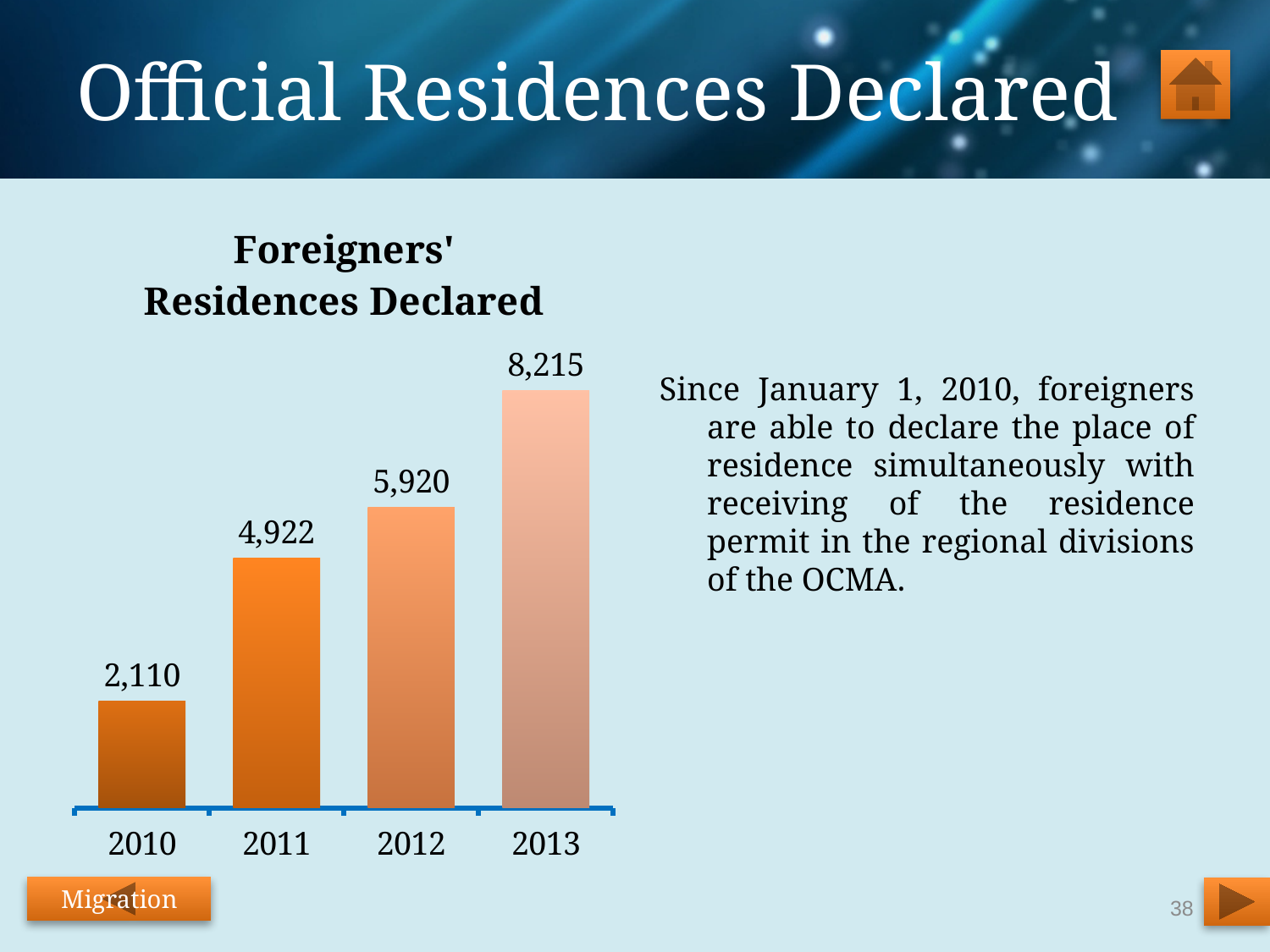
Do the values in the Foreigners' Residences Declared chart rise or fall from 2010 to 2013? rise What is the value for 2010 in the Foreigners' Residences Declared chart? 2,110 What kind of chart is the Foreigners' Residences Declared chart? bar chart Which is larger in the Foreigners' Residences Declared chart, the value for 2011 or the value for 2012? 2012 What is the difference between the values for 2011 and 2010 in the Foreigners' Residences Declared chart? 2,812 Which year has the highest value in the Foreigners' Residences Declared chart? 2013 What is the value for 2013 in the Foreigners' Residences Declared chart? 8,215 Which year has the lowest value in the Foreigners' Residences Declared chart? 2010 What is the value for 2012 in the Foreigners' Residences Declared chart? 5,920 What is the value for 2011 in the Foreigners' Residences Declared chart? 4,922 How many years are shown in the Foreigners' Residences Declared chart? 4 What is the difference between the values for 2013 and 2012 in the Foreigners' Residences Declared chart? 2,295